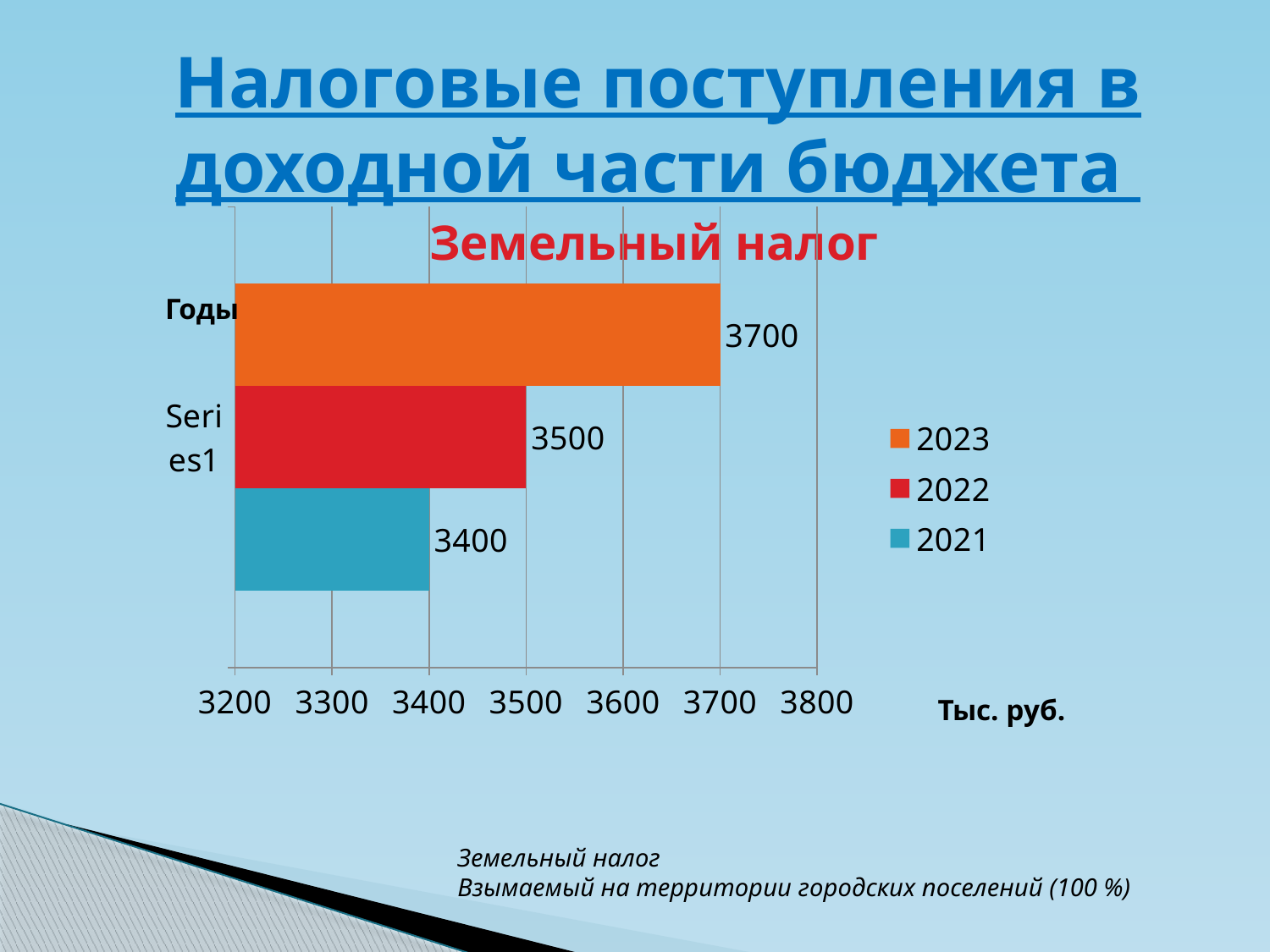
What is the value for 2022 in the Земельный налог chart? 3500 What is the difference between the values for 2022 and 2021? 100 Which year has the lowest value in the Земельный налог chart? 2021 What kind of chart is shown on the slide? bar chart Which year has the highest value in the Земельный налог chart? 2023 Is the value for 2023 greater or less than 3600? greater What is the title of the chart? Земельный налог What is the value for 2023 in the Земельный налог chart? 3700 Which is larger, the value for 2022 or the value for 2021? 2022 What is the difference between the values for 2023 and 2022? 200 What is the value for 2021 in the Земельный налог chart? 3400 How many series does the legend list? 3